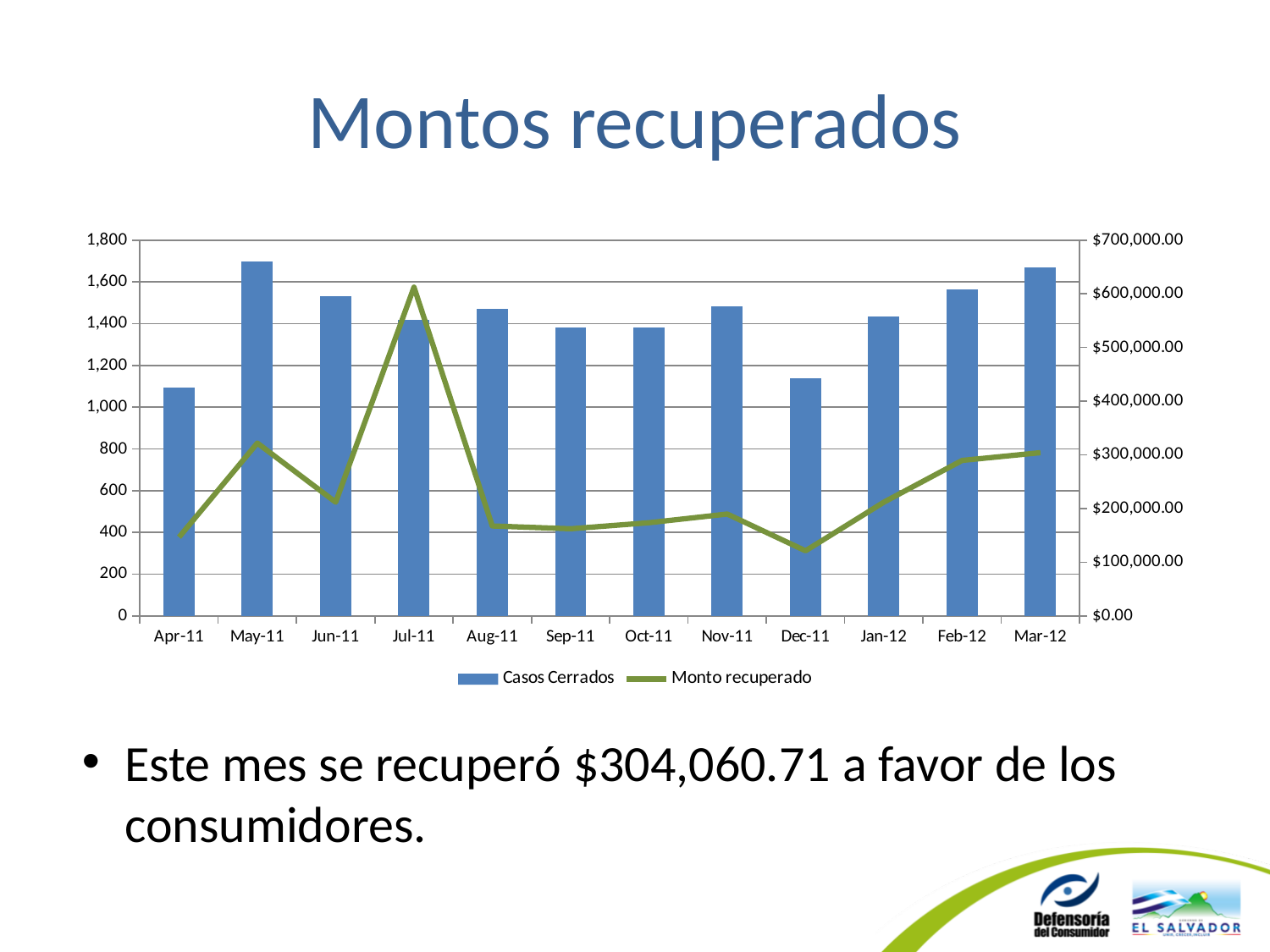
Which month has more Casos Cerrados, Apr-11 or May-11? May-11 How many series does the legend list? 2 Which month has the highest number of Casos Cerrados? May-11 Is the value of Casos Cerrados for May-11 greater or less than 1,600? greater What kind of chart is shown on the slide? A combined bar and line chart Is the Monto recuperado for Dec-11 greater or less than $200,000.00? less Does the Monto recuperado rise or fall from Jul-11 to Aug-11? It falls Which month has the lowest Monto recuperado? Dec-11 Is the Monto recuperado for Jul-11 greater or less than $500,000.00? greater Which month has the highest Monto recuperado? Jul-11 How many months are shown on the x axis? 12